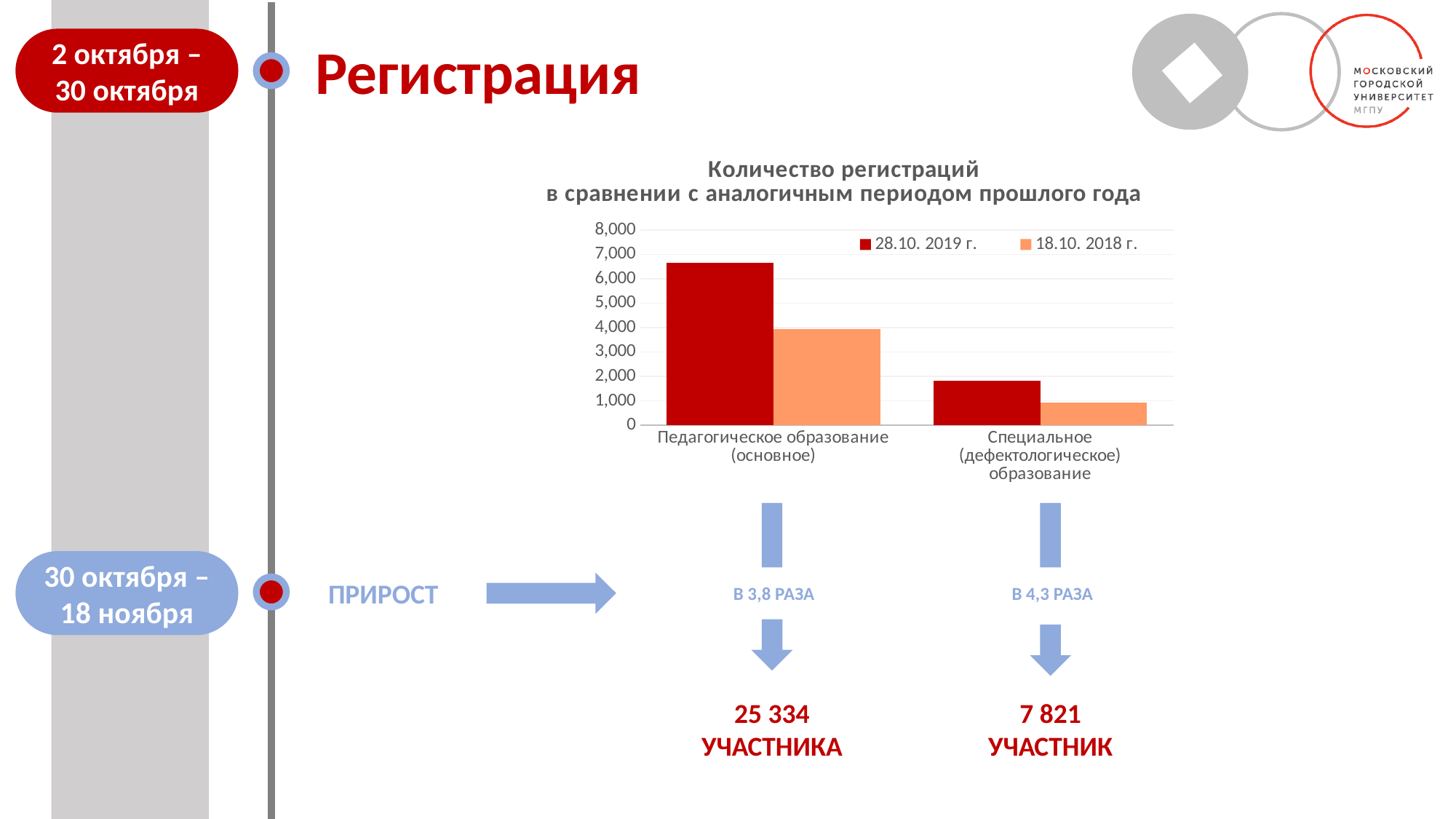
Which category has the highest bar in the chart? Педагогическое образование (основное) How many categories are shown on the x axis of the chart? 2 Which colour represents the 18.10. 2018 г. series in the chart? orange For Специальное (дефектологическое) образование, which series has the larger value: 28.10. 2019 г. or 18.10. 2018 г.? 28.10. 2019 г. What is the title of the chart? Количество регистраций в сравнении с аналогичным периодом прошлого года Is the value for 28.10. 2019 г. in Специальное (дефектологическое) образование greater or less than 2,000? less Is the value for 18.10. 2018 г. in Педагогическое образование (основное) greater or less than 3,000? greater Which series has the lowest bar in the chart, and for which category? 18.10. 2018 г., Специальное (дефектологическое) образование For Педагогическое образование (основное), which series has the larger value: 28.10. 2019 г. or 18.10. 2018 г.? 28.10. 2019 г. How many series does the chart legend list? 2 Is the value for 28.10. 2019 г. in Педагогическое образование (основное) greater or less than 6,000? greater What kind of chart is shown on the slide? bar chart